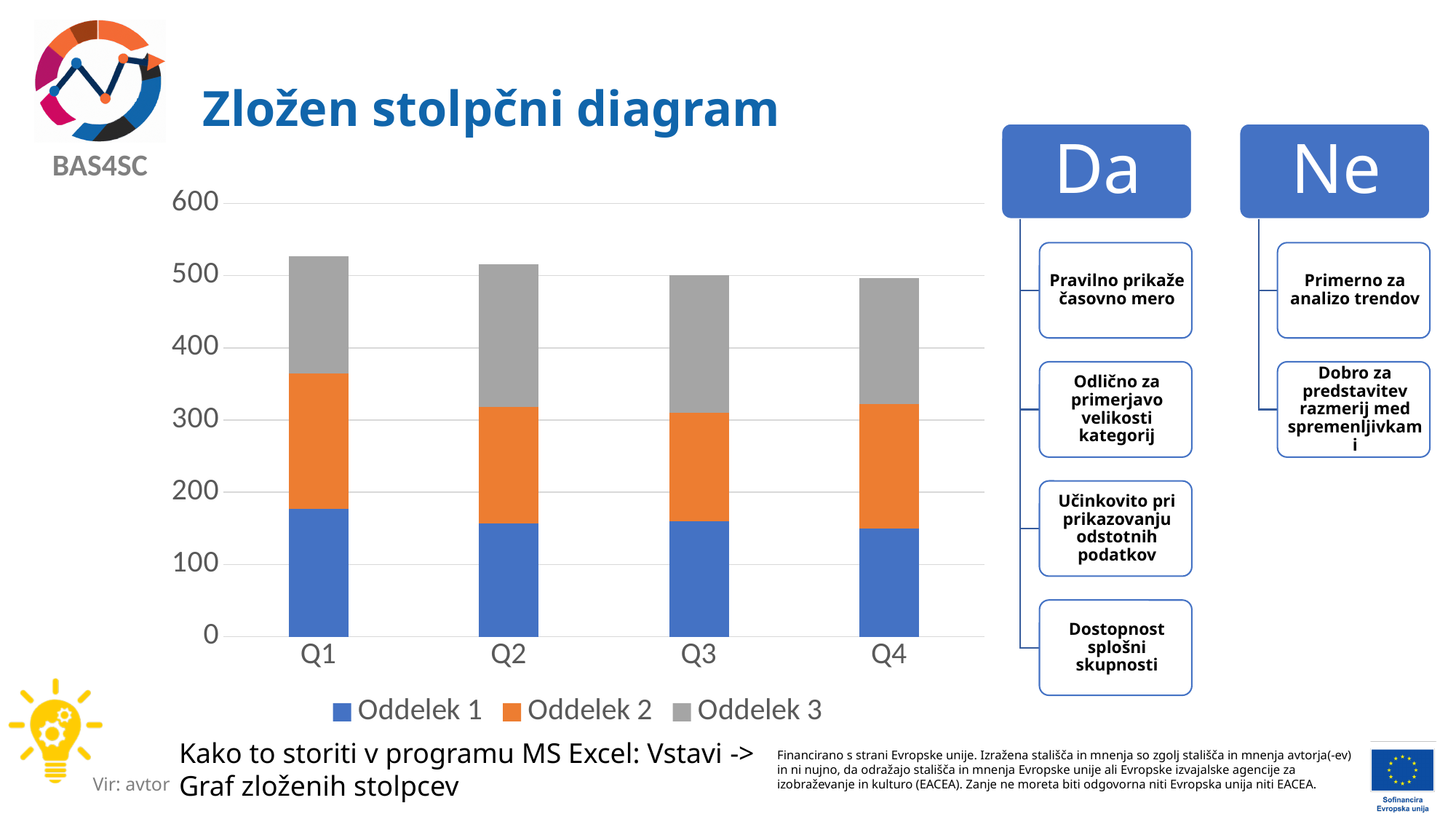
What kind of chart is shown on the slide? stacked bar chart How many series does the chart legend list? 3 Is the total height of the stacked bar for Q2 greater or less than 600? less How many categories are shown on the x axis of the chart? 4 Do the total heights of the stacked bars generally rise or fall from Q1 to Q4? fall Which series is shown in orange in the chart? Oddelek 2 What is the title of the slide containing the chart? Zložen stolpčni diagram Is the value of Oddelek 1 for Q4 greater or less than 100? greater Which quarter has the larger value for Oddelek 1, Q1 or Q4? Q1 Which stacked bar is taller in total, Q1 or Q4? Q1 Is the total height of the stacked bar for Q1 greater or less than 500? greater